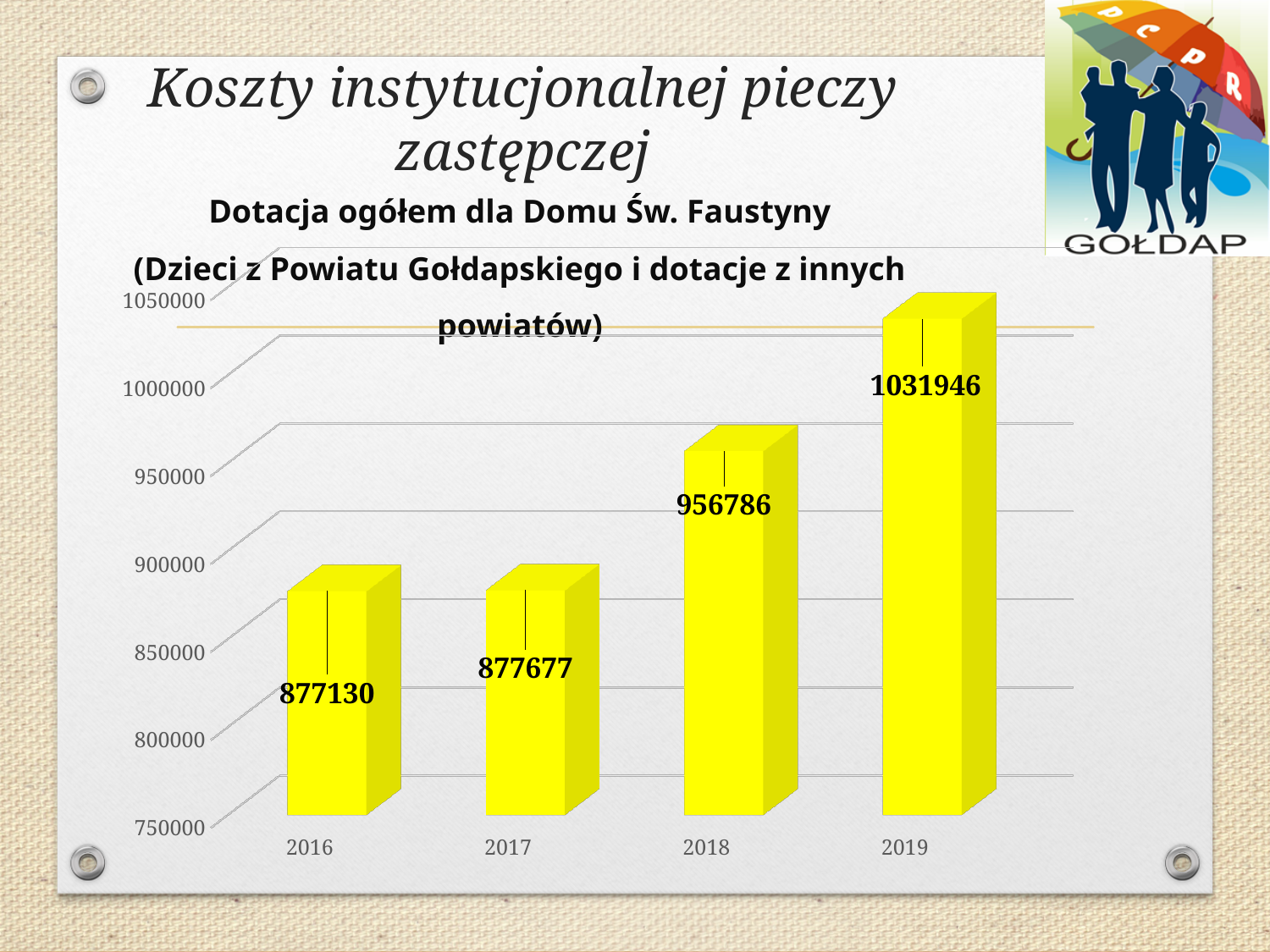
What is the value for 2016? 877130 Is the value for 2018 greater or less than 1000000? less What kind of chart is shown? bar chart Which year has the lowest value? 2016 Which is larger, the value for 2018 or the value for 2019? 2019 Which year has the highest value? 2019 How many years are shown on the x axis? 4 What is the value for 2018? 956786 What is the difference between the values for 2019 and 2018? 75160 What is the value for 2017? 877677 What is the difference between the values for 2019 and 2016? 154816 What is the value for 2019? 1031946